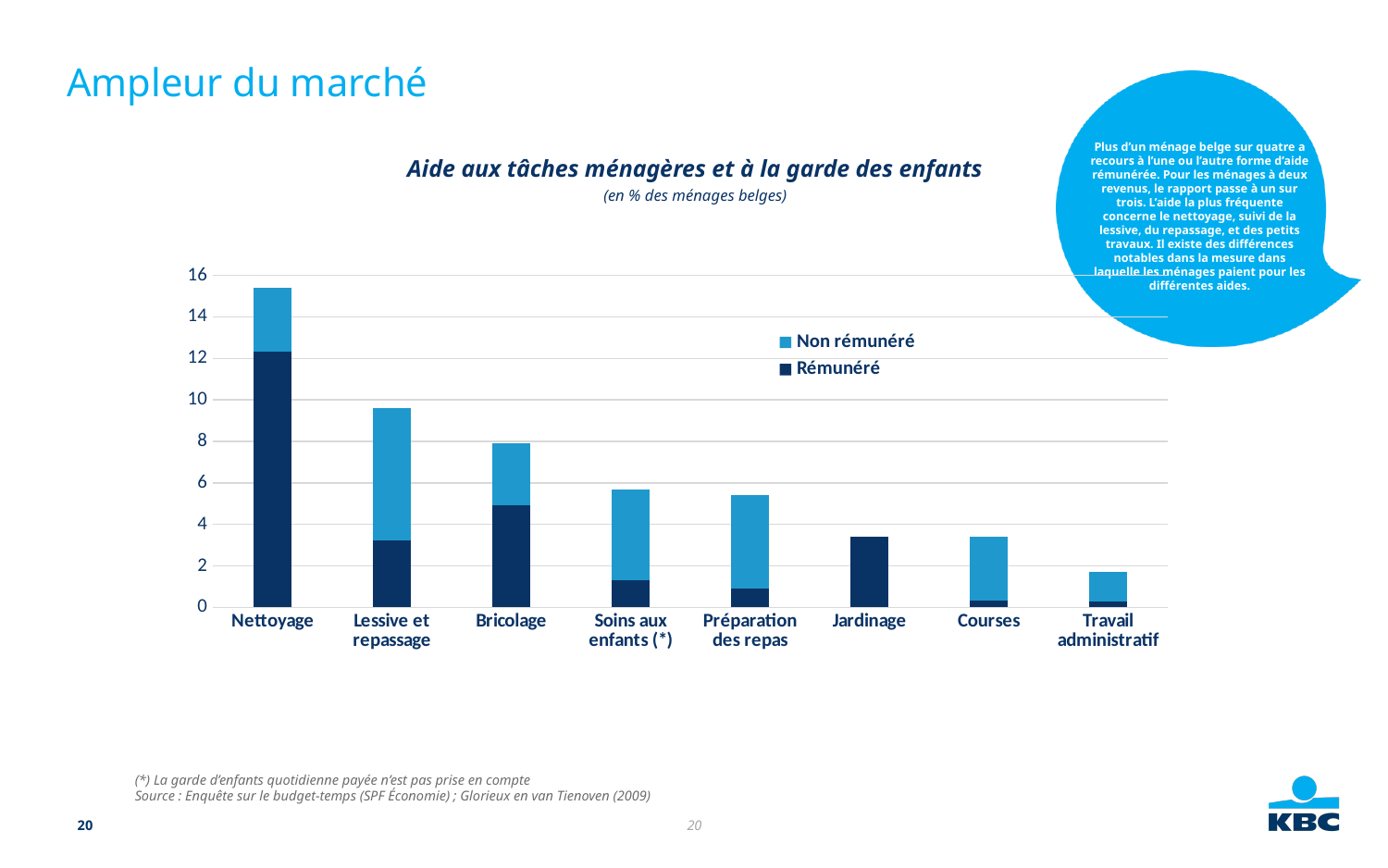
How many series does the chart legend list? 2 Is the total value for Travail administratif greater or less than 2? less Which category has the lowest total bar in the chart? Travail administratif Is the total value for Lessive et repassage greater or less than 10? less What kind of chart is shown on the slide? stacked bar chart Is the total value for Nettoyage greater or less than 14? greater How many categories are shown on the x axis of the chart? 8 Do the total bar heights generally rise or fall from left to right along the x axis? fall Which category has the highest total bar in the chart? Nettoyage What is the title of the chart? Aide aux tâches ménagères et à la garde des enfants Which has the larger total bar, Bricolage or Soins aux enfants (*)? Bricolage